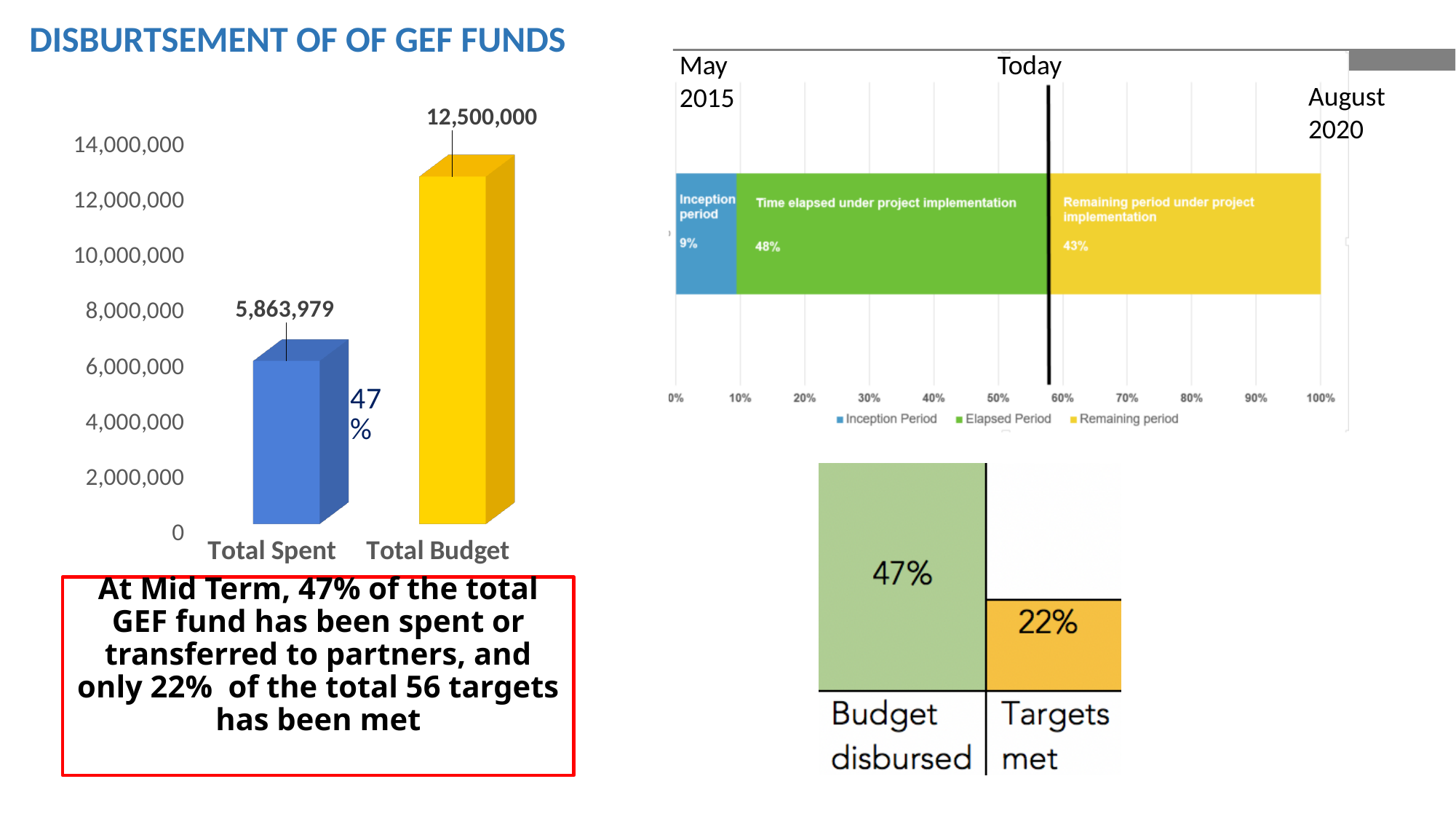
In the 'DISBURTSEMENT OF OF GEF FUNDS' chart, how many categories are plotted? 2 In the 'DISBURTSEMENT OF OF GEF FUNDS' chart, which category has the higher value? Total Budget In the timeline chart at the top right, what percentage is the Inception period? 9% In the timeline chart at the top right, what percentage is the remaining period under project implementation? 43% In the 'DISBURTSEMENT OF OF GEF FUNDS' chart, what is the difference between Total Budget and Total Spent? 6,636,021 In the timeline chart at the top right, how many series does the legend list? 3 In the chart at the bottom right, which is larger, Budget disbursed or Targets met? Budget disbursed In the chart at the bottom right, what is the value for Targets met? 22% What kind of chart is the 'DISBURTSEMENT OF OF GEF FUNDS' chart? Bar chart In the 'DISBURTSEMENT OF OF GEF FUNDS' chart, what is the value for Total Spent? 5,863,979 In the timeline chart at the top right, what percentage is the time elapsed under project implementation? 48% In the 'DISBURTSEMENT OF OF GEF FUNDS' chart, what is the value for Total Budget? 12,500,000